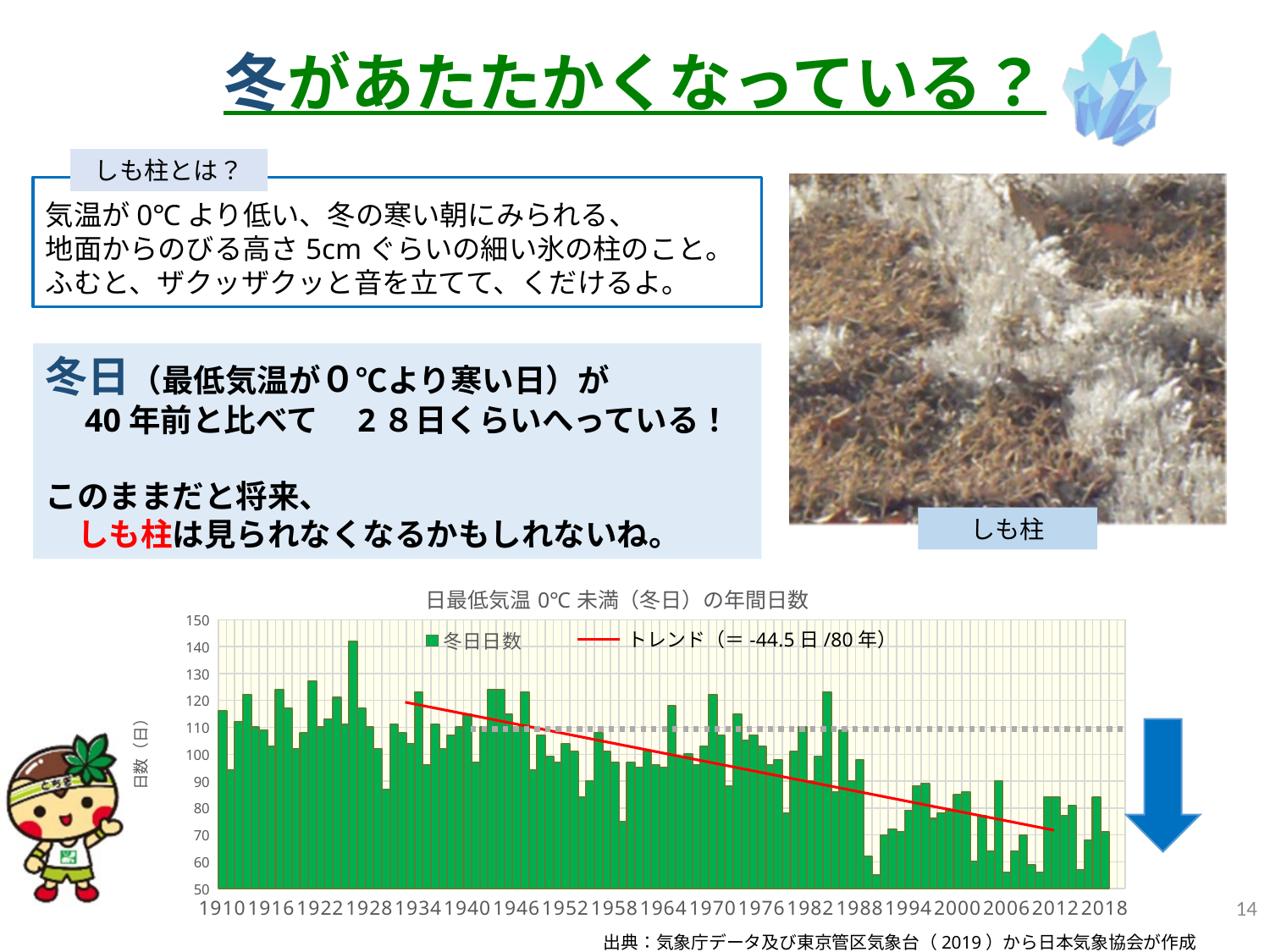
Which year has the larger value of 冬日日数, 1910 or 2018? 1910 Is the value for 2018 greater or less than 80? less How many entries does the chart's legend list? 2 Is the value for 1934 greater or less than 110? greater What kind of chart is shown at the bottom of the slide? bar chart What is the lowest value shown on the chart's vertical axis? 50 What trend value is given in the chart legend for the トレンド line? -44.5 日 /80 年 Is the value for 1910 greater or less than 100? greater What is the title of the chart? 日最低気温 0℃ 未満（冬日）の年間日数 Do the values of 冬日日数 generally rise or fall from 1910 to 2018? fall